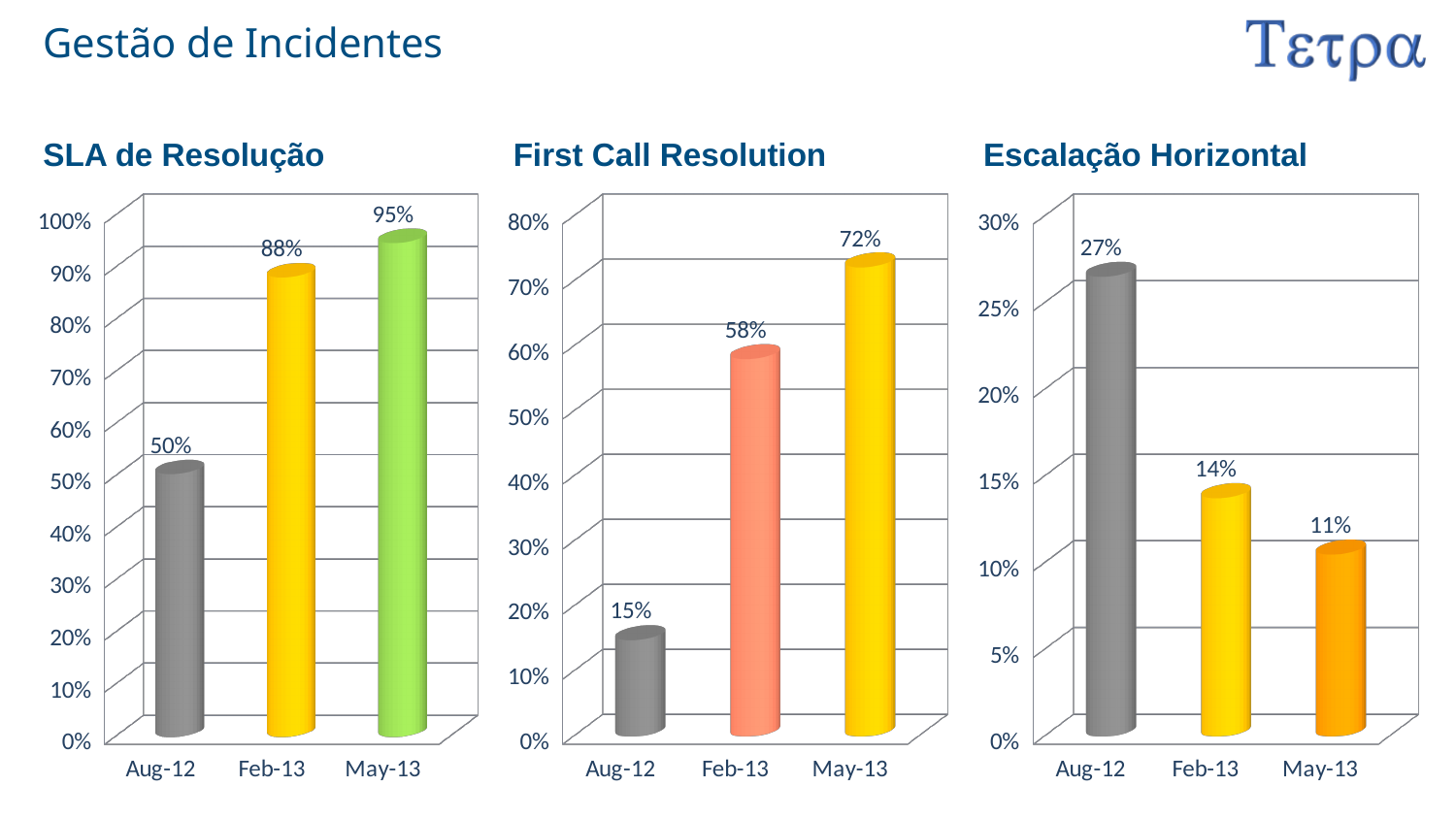
In the 'First Call Resolution' chart, how many periods are shown on the x axis? 3 In the 'Escalação Horizontal' chart, do the values rise or fall from Aug-12 to May-13? fall In the 'Escalação Horizontal' chart, which period has the lowest value? May-13 In the 'Escalação Horizontal' chart, which is larger, the value for Aug-12 or the value for Feb-13? Aug-12 In the 'First Call Resolution' chart, what is the difference between the May-13 and Aug-12 values? 57% In the 'SLA de Resolução' chart, what is the difference between the Feb-13 and Aug-12 values? 38% In the 'SLA de Resolução' chart, what is the value for Feb-13? 88% In the 'SLA de Resolução' chart, which period has the highest value? May-13 In the 'First Call Resolution' chart, what is the value for Aug-12? 15% In the 'First Call Resolution' chart, do the values rise or fall from Aug-12 to May-13? rise What kind of chart is the 'Escalação Horizontal' chart? bar chart In the 'Escalação Horizontal' chart, what is the value for May-13? 11%